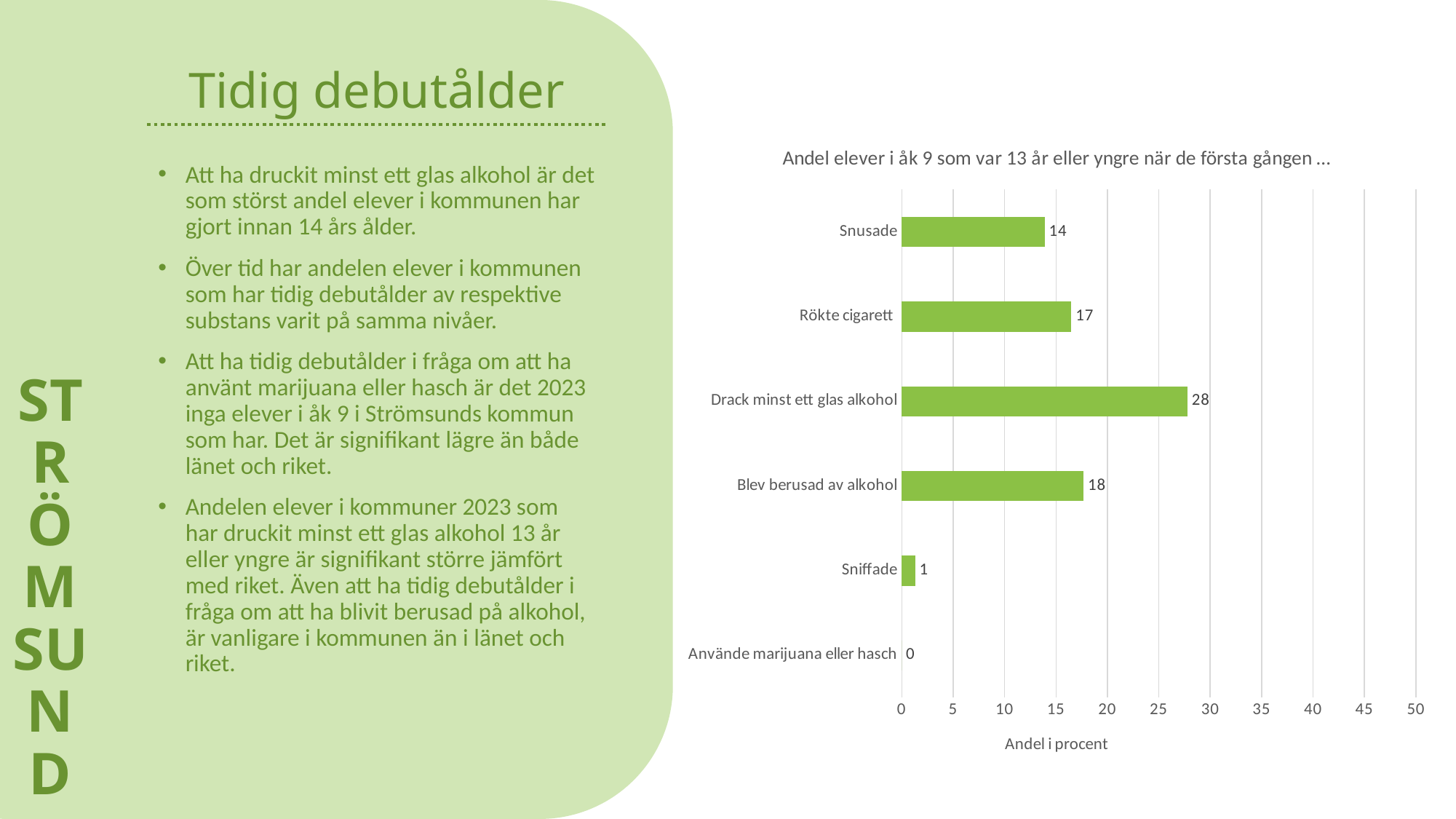
What is the value for Drack minst ett glas alkohol? 28 What is the value for Snusade? 14 How many categories are shown in the chart? 6 Which category has the lowest value? Använde marijuana eller hasch Which category has the highest value? Drack minst ett glas alkohol What is the difference between the values for Drack minst ett glas alkohol and Blev berusad av alkohol? 10 Is the value for Blev berusad av alkohol greater or less than 20? less What is the label of the horizontal axis? Andel i procent What is the value for Använde marijuana eller hasch? 0 What is the value for Rökte cigarett? 17 Which is larger, the value for Rökte cigarett or the value for Snusade? Rökte cigarett What kind of chart is shown on the slide? bar chart